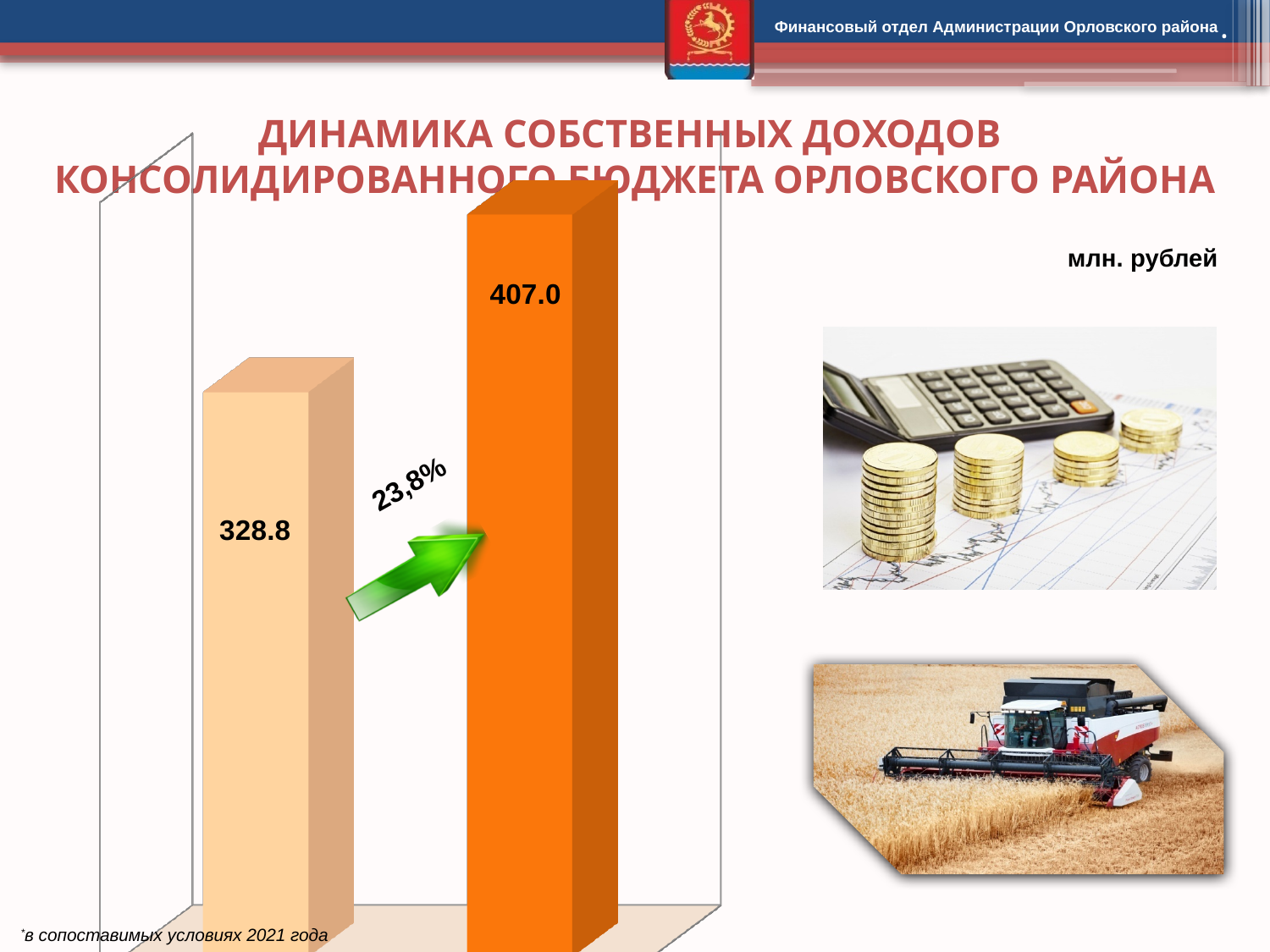
What percentage change is written next to the green arrow between the bars? 23,8% In what units are the chart values expressed, according to the label on the slide? млн. рублей Which bar has the lowest value, the left or the right one? the left bar (328.8) What kind of chart is shown on the slide? bar chart Which is larger, the value of the left bar or the value of the right bar? the right bar How many bars are plotted on the chart? 2 What is the difference between the right bar (407.0) and the left bar (328.8)? 78.2 Which bar has the highest value, the left or the right one? the right bar (407.0) What is the value shown on the left (light orange) bar? 328.8 Do the values rise or fall from the left bar to the right bar? rise What is the value shown on the right (dark orange) bar? 407.0